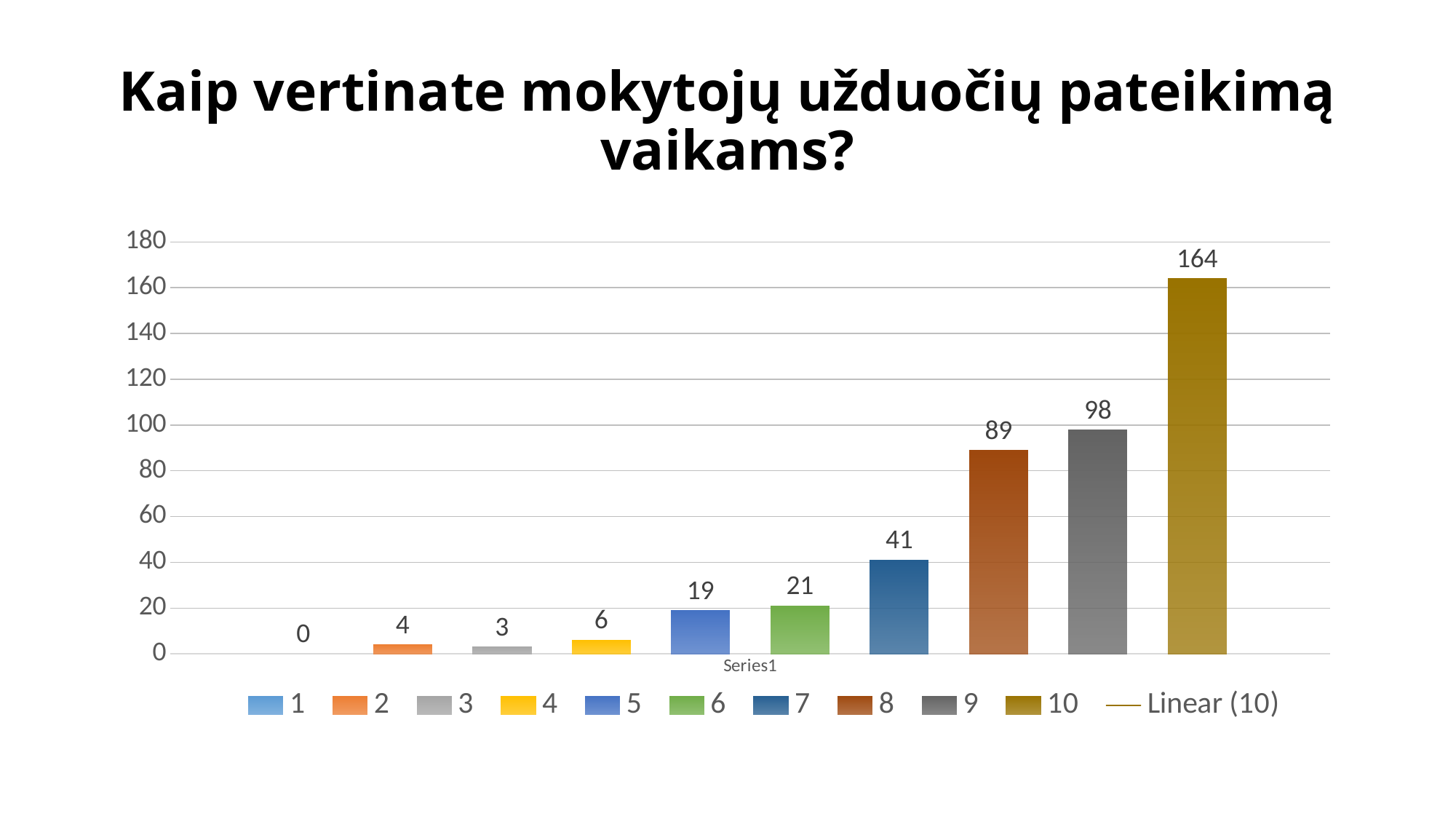
Which rating has the lowest value? 1 Which rating has the highest value? 10 What is the title of the chart? Kaip vertinate mokytojų užduočių pateikimą vaikams? Is the value for rating 9 greater or less than 100? less What is the value for rating 7? 41 Do the values generally rise or fall from rating 1 to rating 10? rise What is the difference between the values for rating 10 and rating 9? 66 Which is larger, the value for rating 6 or the value for rating 5? 6 What is the value for rating 5? 19 What is the difference between the values for rating 8 and rating 7? 48 What is the value for rating 10? 164 What kind of chart is shown on the slide? bar chart